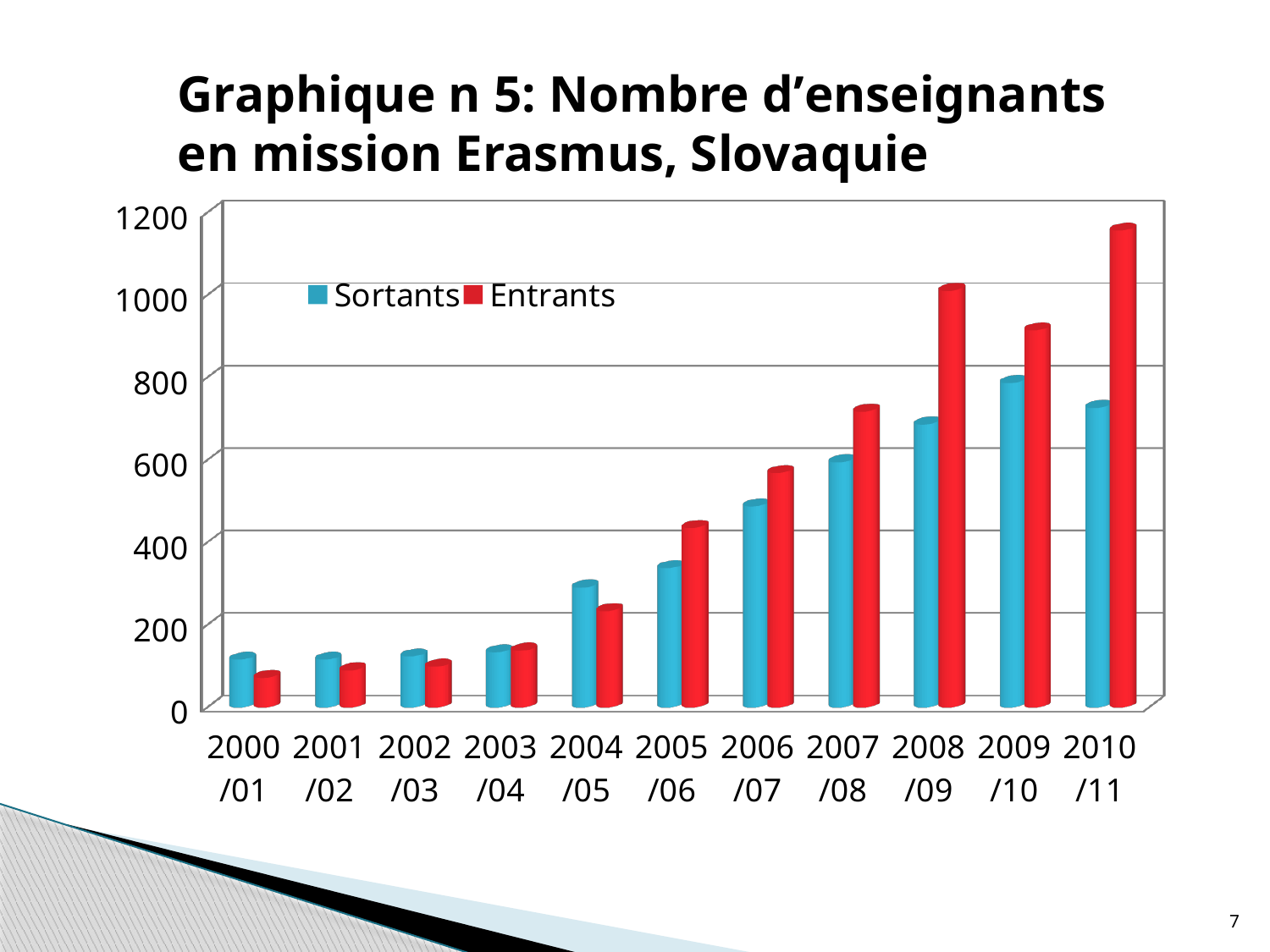
How many series does the legend list? 2 In which year is the value for Sortants highest? 2009/10 Is the value for Sortants in 2004/05 greater or less than 400? less How many academic years are shown on the x axis? 11 Is the value for Sortants in 2008/09 greater or less than 600? greater In which year is the value for Entrants lowest? 2000/01 What kind of chart is shown on the slide? bar chart In 2008/09, which is larger, Sortants or Entrants? Entrants In which year is the value for Entrants highest? 2010/11 Is the value for Entrants in 2010/11 greater or less than 1000? greater In 2004/05, which is larger, Sortants or Entrants? Sortants What colour represents the Entrants series? red